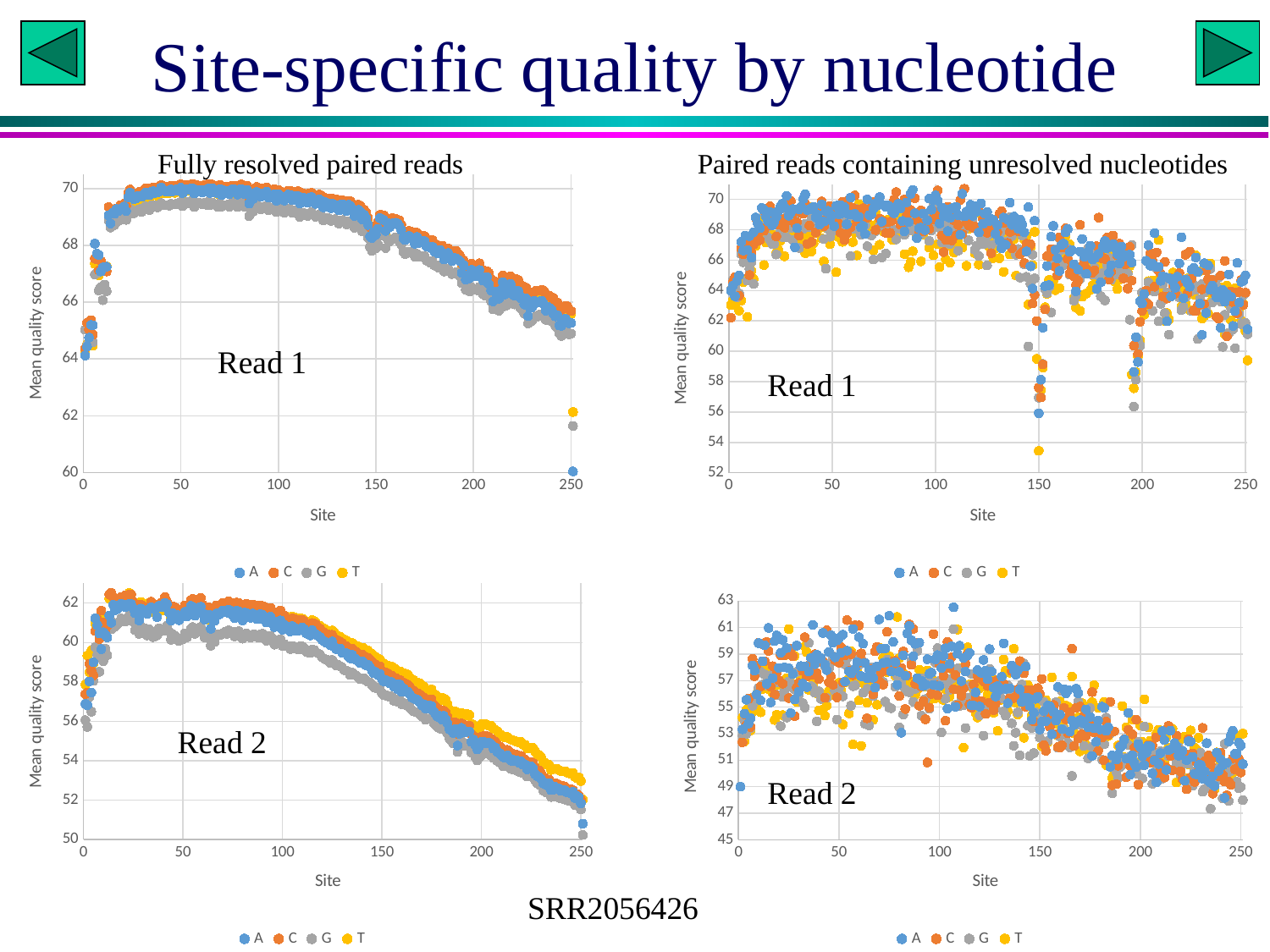
What kind of chart is the top-left chart (Fully resolved paired reads, Read 1)? scatter chart In the bottom-left chart (Fully resolved paired reads, Read 2), which series has the higher value at site 250, A or T? T In the top-left chart (Fully resolved paired reads, Read 1), which series has the lowest values around site 100? G In the top-left chart (Fully resolved paired reads, Read 1), are the values at site 50 greater or less than 68? greater In the top-right chart (Paired reads containing unresolved nucleotides, Read 1), are the values at site 50 greater or less than 64? greater In the top-left chart (Fully resolved paired reads, Read 1), do the values rise or fall from site 100 to site 250? fall What is the y-axis title of the bottom-right chart (Paired reads containing unresolved nucleotides, Read 2)? Mean quality score How many series does the legend list for the bottom-left chart (Fully resolved paired reads, Read 2)? 4 In the bottom-right chart (Paired reads containing unresolved nucleotides, Read 2), are the values at site 250 greater or less than 55? less What are the legend entries for the top-right chart (Paired reads containing unresolved nucleotides, Read 1)? A, C, G, T In the bottom-left chart (Fully resolved paired reads, Read 2), do the values rise or fall from site 100 to site 250? fall